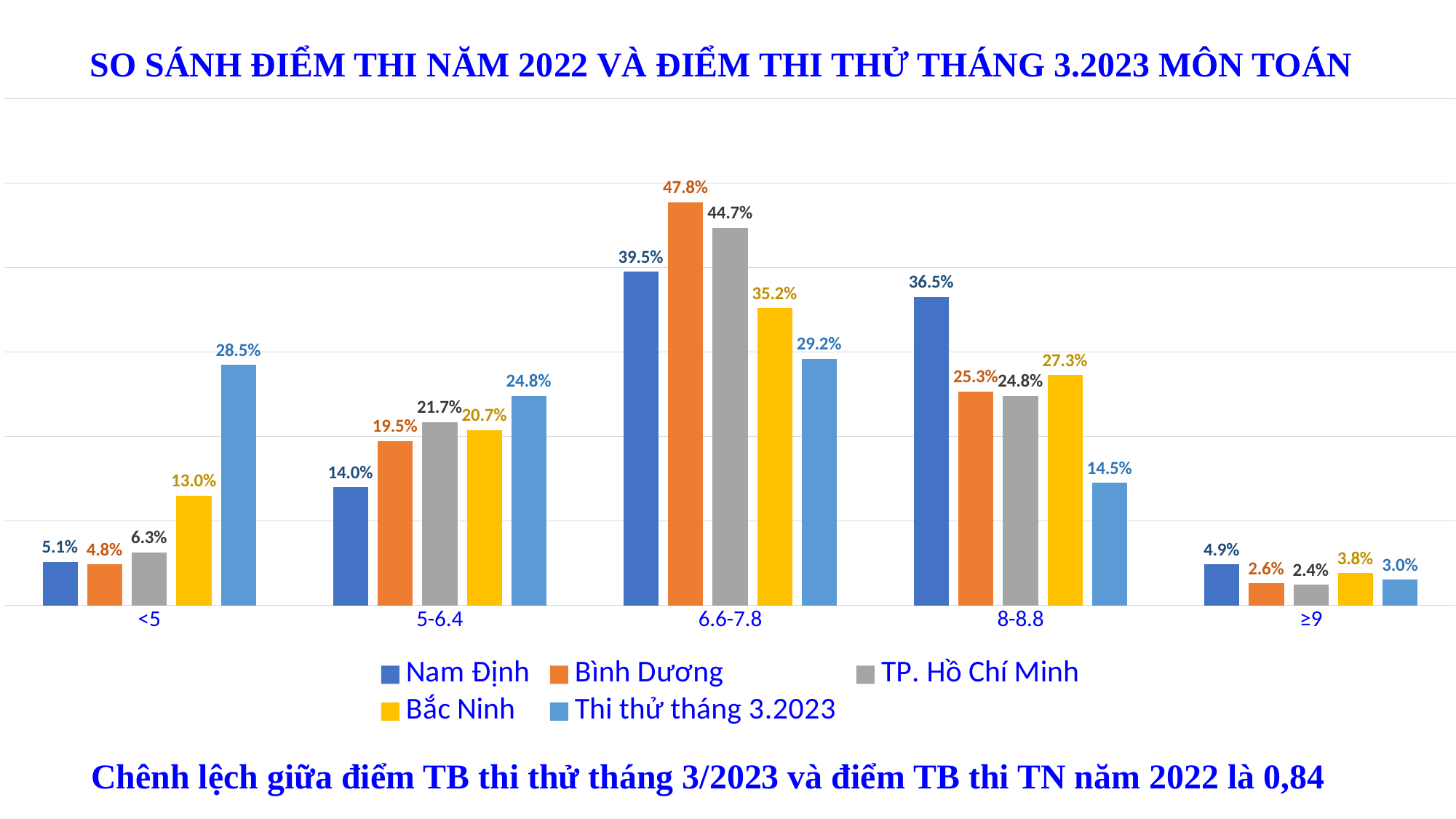
Which category has the highest value for Nam Định? 6.6-7.8 What is the value for Bắc Ninh in the 8-8.8 category? 27.3% What is the difference between Nam Định and Thi thử tháng 3.2023 in the 8-8.8 category? 22.0% What is the value for Bình Dương in the 6.6-7.8 category? 47.8% Which series has the highest value in the 6.6-7.8 category? Bình Dương How many series does the legend list? 5 What is the value for Thi thử tháng 3.2023 in the <5 category? 28.5% How many score categories are shown on the x axis? 5 Which is larger in the 5-6.4 category: TP. Hồ Chí Minh or Bắc Ninh? TP. Hồ Chí Minh What is the title of the chart? SO SÁNH ĐIỂM THI NĂM 2022 VÀ ĐIỂM THI THỬ THÁNG 3.2023 MÔN TOÁN What kind of chart is shown on the slide? bar chart Which series has the lowest value in the ≥9 category? TP. Hồ Chí Minh